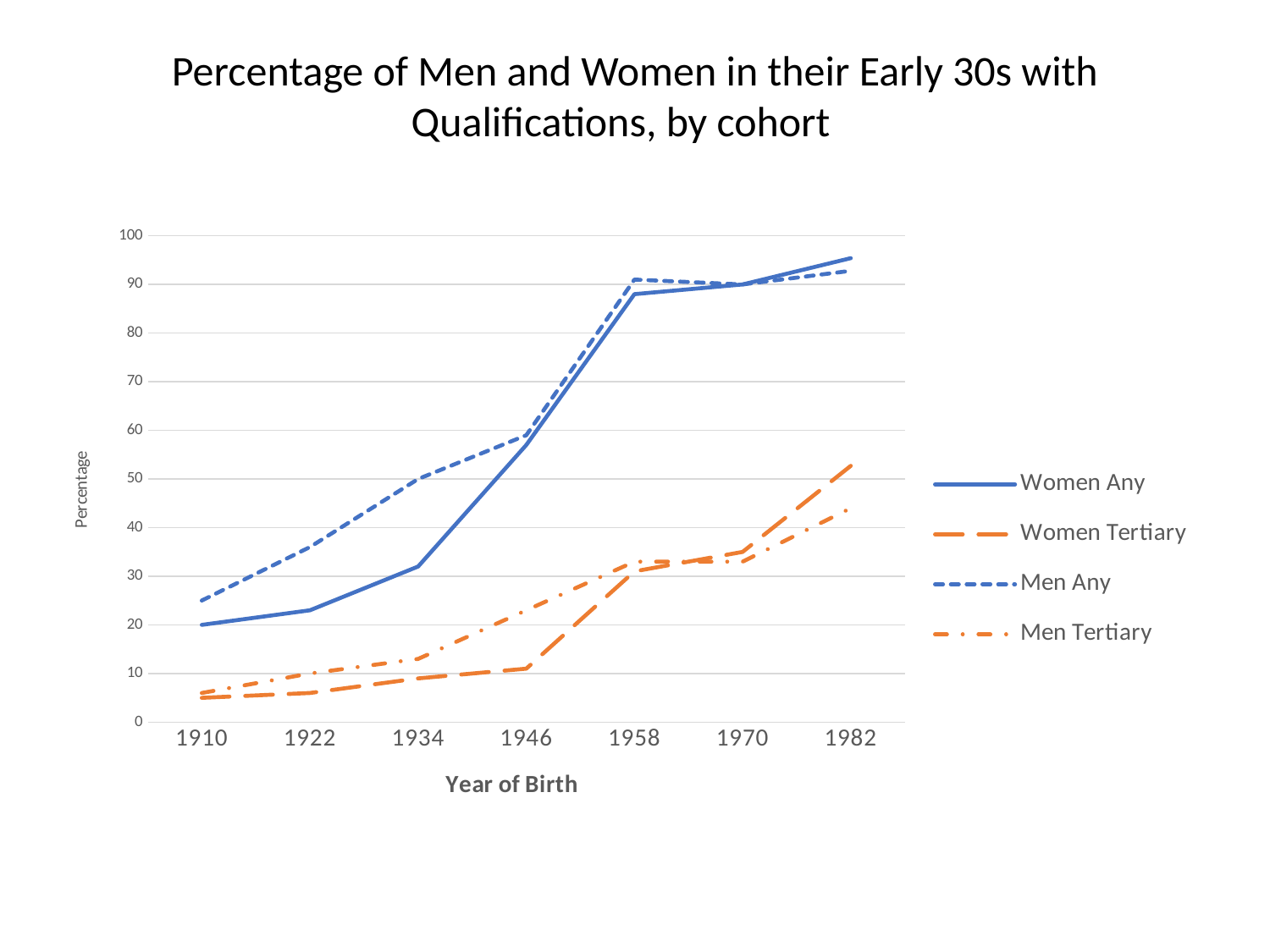
Is the Women Any value for the 1934 cohort greater or less than 40? less For the 1934 cohort, which is larger: Men Any or Women Any? Men Any How many series does the legend list? 4 Is the Women Tertiary value for the 1982 cohort greater or less than 40? greater Which series has the highest value for the 1982 cohort? Women Any Is the Men Any value for the 1946 cohort greater or less than 50? greater How many birth-year cohorts are plotted along the x axis? 7 Does the Women Any series rise or fall from the 1910 cohort to the 1982 cohort? Rise What is the title of the x axis? Year of Birth What kind of chart is shown on the slide? Line chart For the 1946 cohort, which is larger: Men Tertiary or Women Tertiary? Men Tertiary For which year of birth is the Women Tertiary value lowest? 1910